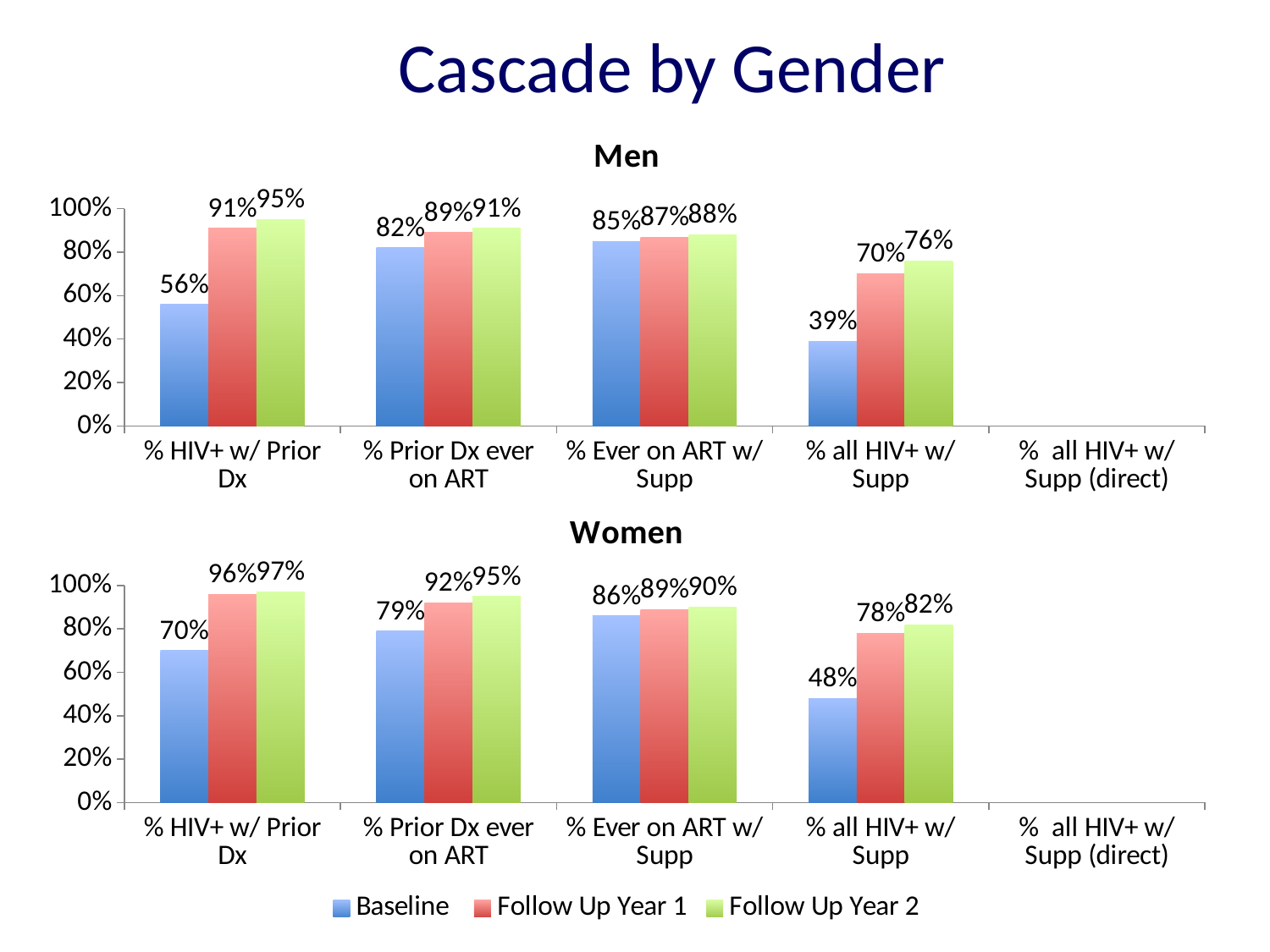
In the Women chart, do the values for % Prior Dx ever on ART rise or fall from Baseline to Follow Up Year 2? rise In the Men chart, what is the Baseline value for % HIV+ w/ Prior Dx? 56% In the Men chart, what is the difference between the Follow Up Year 2 and Baseline values for % all HIV+ w/ Supp? 37% In the Men chart, what is the Follow Up Year 1 value for % Prior Dx ever on ART? 89% In the Women chart, which category has the lowest Baseline value? % all HIV+ w/ Supp In the Men chart, which category has the highest Follow Up Year 2 value? % HIV+ w/ Prior Dx How many series does the legend list? 3 In the Men chart, is the Baseline value for % all HIV+ w/ Supp greater or less than 40%? less In the Women chart, what is the Follow Up Year 2 value for % all HIV+ w/ Supp? 82% What type of chart is the Women chart? bar chart Is the Baseline value for % HIV+ w/ Prior Dx larger in the Men chart or the Women chart? Women In the Women chart, what is the difference between the Follow Up Year 1 and Baseline values for % HIV+ w/ Prior Dx? 26%